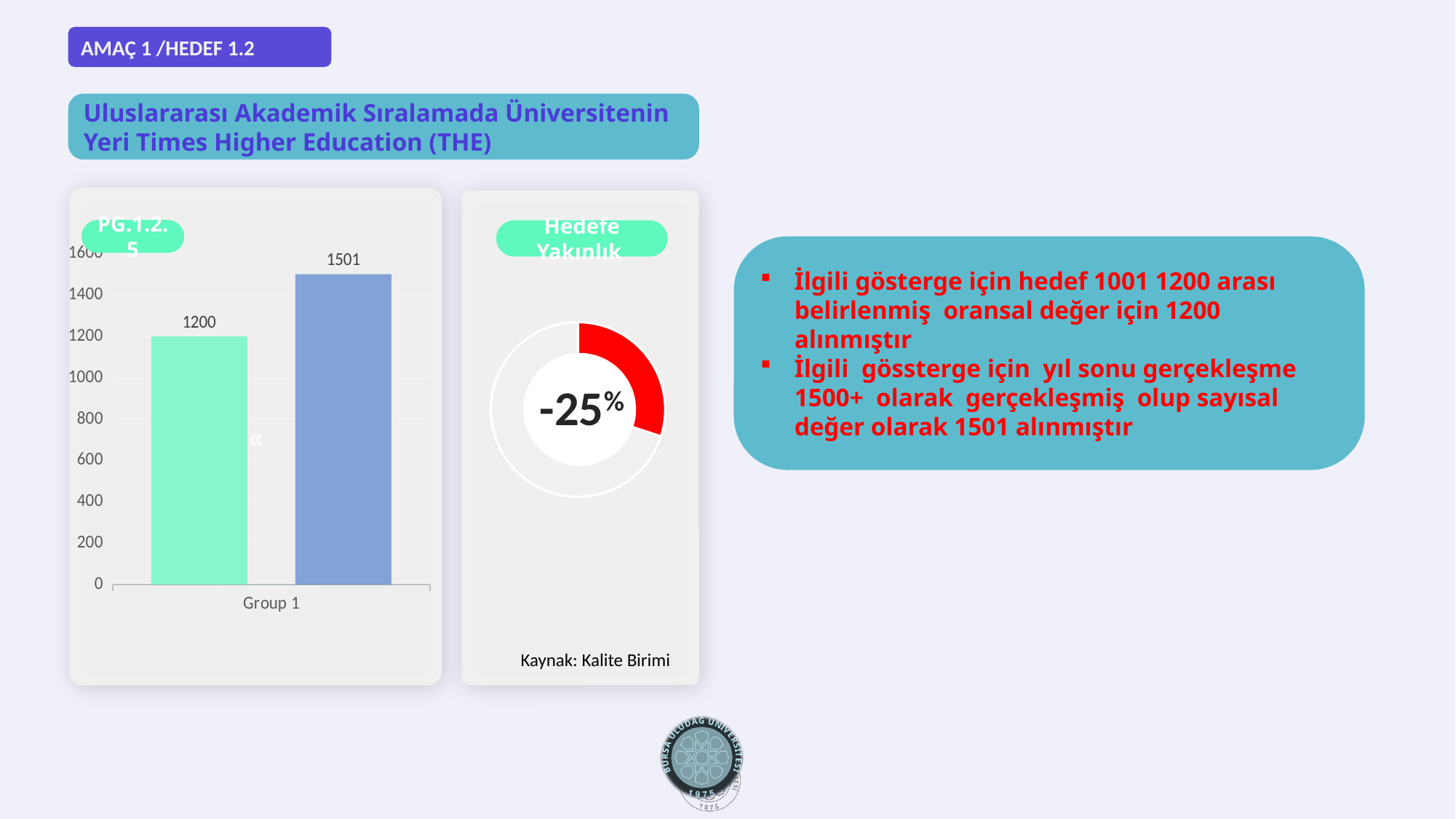
In the bar chart on the left, what value is shown on the blue bar? 1501 What percentage is shown in the centre of the 'Hedefe Yakınlık' doughnut chart? -25% In the bar chart on the left, is the value of the blue bar greater or less than 1400? greater In the bar chart on the left, what is the category label on the x axis? Group 1 What kind of chart is shown on the left of the slide? bar chart What is the highest tick value on the y axis of the bar chart on the left? 1600 In the bar chart on the left, what is the lowest value shown? 1200 In the bar chart on the left, what is the highest value shown? 1501 In the bar chart on the left, what value is shown on the green bar? 1200 In the bar chart on the left, how many bars are plotted? 2 In the bar chart on the left, which bar is taller, the green one or the blue one? the blue one In the bar chart on the left, what is the difference between the blue bar and the green bar? 301